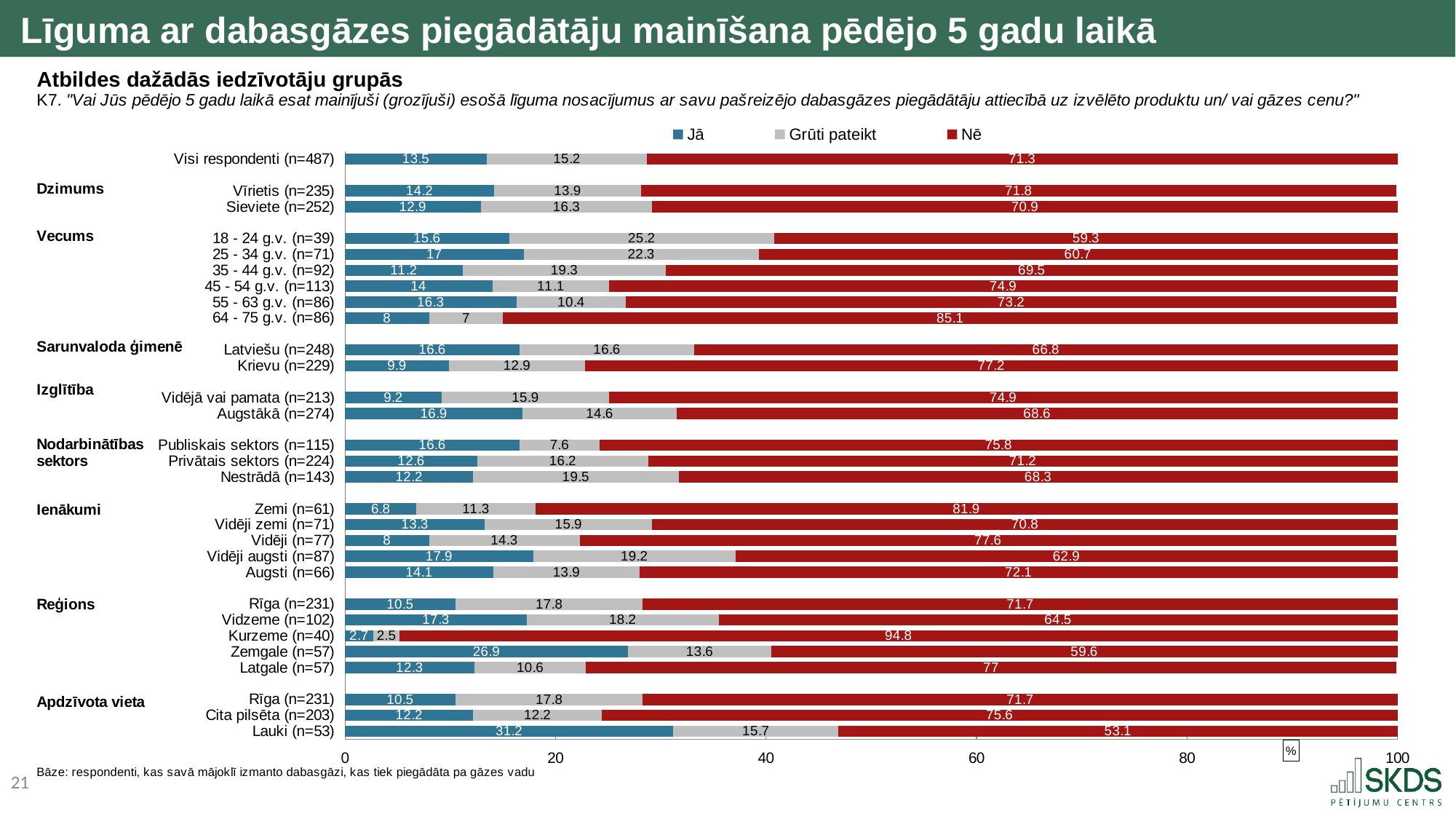
What colour represents the "Nē" series in the legend? Red How many series does the legend list? 3 What is the value of "Grūti pateikt" for 18 - 24 g.v. (n=39)? 25.2 Which group has the lowest "Jā" value? Kurzeme (n=40) What kind of chart is shown on the slide? Stacked bar chart What is the value of "Jā" for Visi respondenti (n=487)? 13.5 What is the difference between the "Jā" values for Lauki (n=53) and Zemgale (n=57)? 4.3 What is the value of "Nē" for Kurzeme (n=40)? 94.8 Is the "Nē" value for 64 - 75 g.v. (n=86) greater or less than 80? greater What is the total of the stacked bar for Visi respondenti (n=487)? 100 Which has a larger "Jā" value, Latviešu (n=248) or Krievu (n=229)? Latviešu (n=248) Which group has the highest "Jā" value? Lauki (n=53)